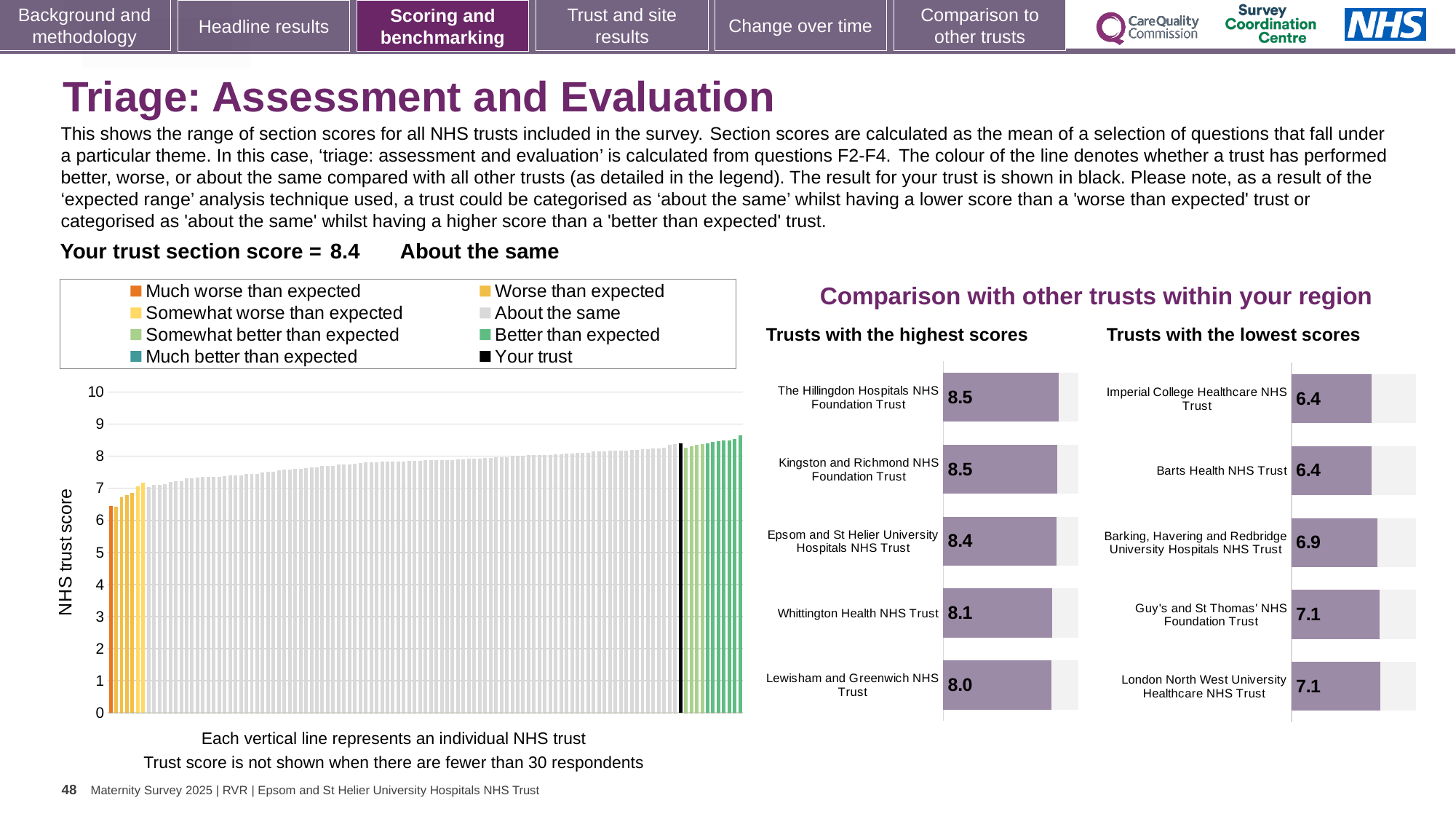
How many entries does the legend above the 'NHS trust score' chart list? 8 In the 'Trusts with the highest scores' chart, what is the score for Whittington Health NHS Trust? 8.1 What kind of chart is the large 'NHS trust score' chart on the left? bar chart In the 'Trusts with the highest scores' chart, what is the difference between The Hillingdon Hospitals NHS Foundation Trust and Lewisham and Greenwich NHS Trust? 0.5 In the 'NHS trust score' chart, what colour is used for the 'Your trust' bar? black Comparing the two regional charts, which has the higher score: Whittington Health NHS Trust or Barking, Havering and Redbridge University Hospitals NHS Trust? Whittington Health NHS Trust How many trusts are listed in the 'Trusts with the highest scores' chart? 5 In the 'Trusts with the lowest scores' chart, what is the score for Barking, Havering and Redbridge University Hospitals NHS Trust? 6.9 In the 'Trusts with the lowest scores' chart, what is the difference between London North West University Healthcare NHS Trust and Imperial College Healthcare NHS Trust? 0.7 In the 'NHS trust score' chart, is the value of the leftmost (lowest) bar greater or less than 7? less In the 'Trusts with the highest scores' chart, which trust has the lowest score shown? Lewisham and Greenwich NHS Trust In the 'NHS trust score' chart, what is the section score for your trust (the black bar)? 8.4